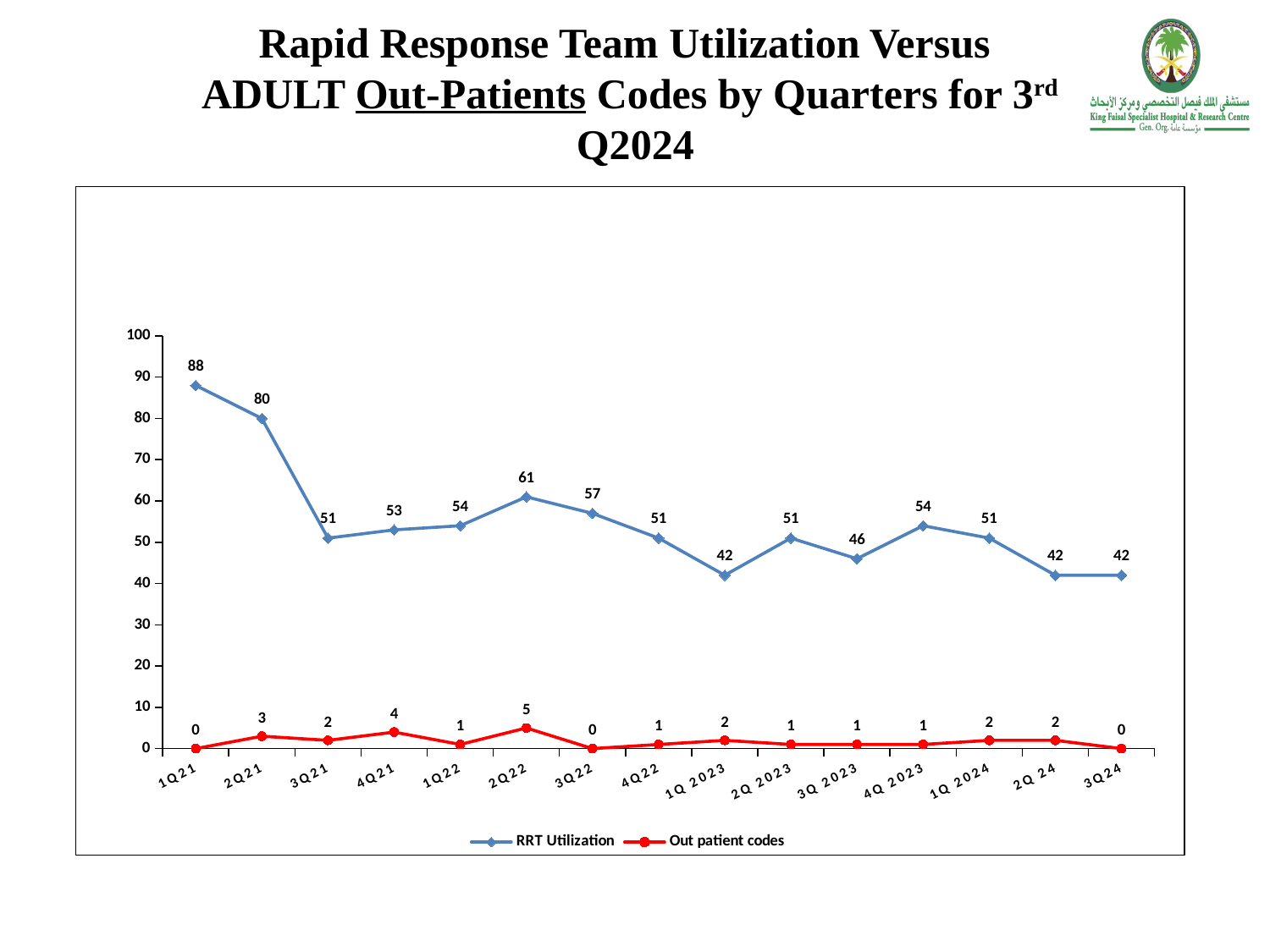
What is the difference between RRT Utilization in 1Q21 and 2Q21? 8 How many series does the legend list? 2 What is the RRT Utilization value for 3Q24? 42 What is the difference between RRT Utilization in 2Q22 and 3Q24? 19 How many quarters are plotted on the x axis? 15 Does RRT Utilization rise or fall from 1Q21 to 3Q21? Fall What is the Out patient codes value for 2Q22? 5 In which quarter are Out patient codes highest? 2Q22 Which is larger, RRT Utilization in 4Q 2023 or in 3Q 2023? 4Q 2023 What kind of chart is shown on the slide? Line chart In which quarter is RRT Utilization highest? 1Q21 What is the RRT Utilization value for 1Q21? 88